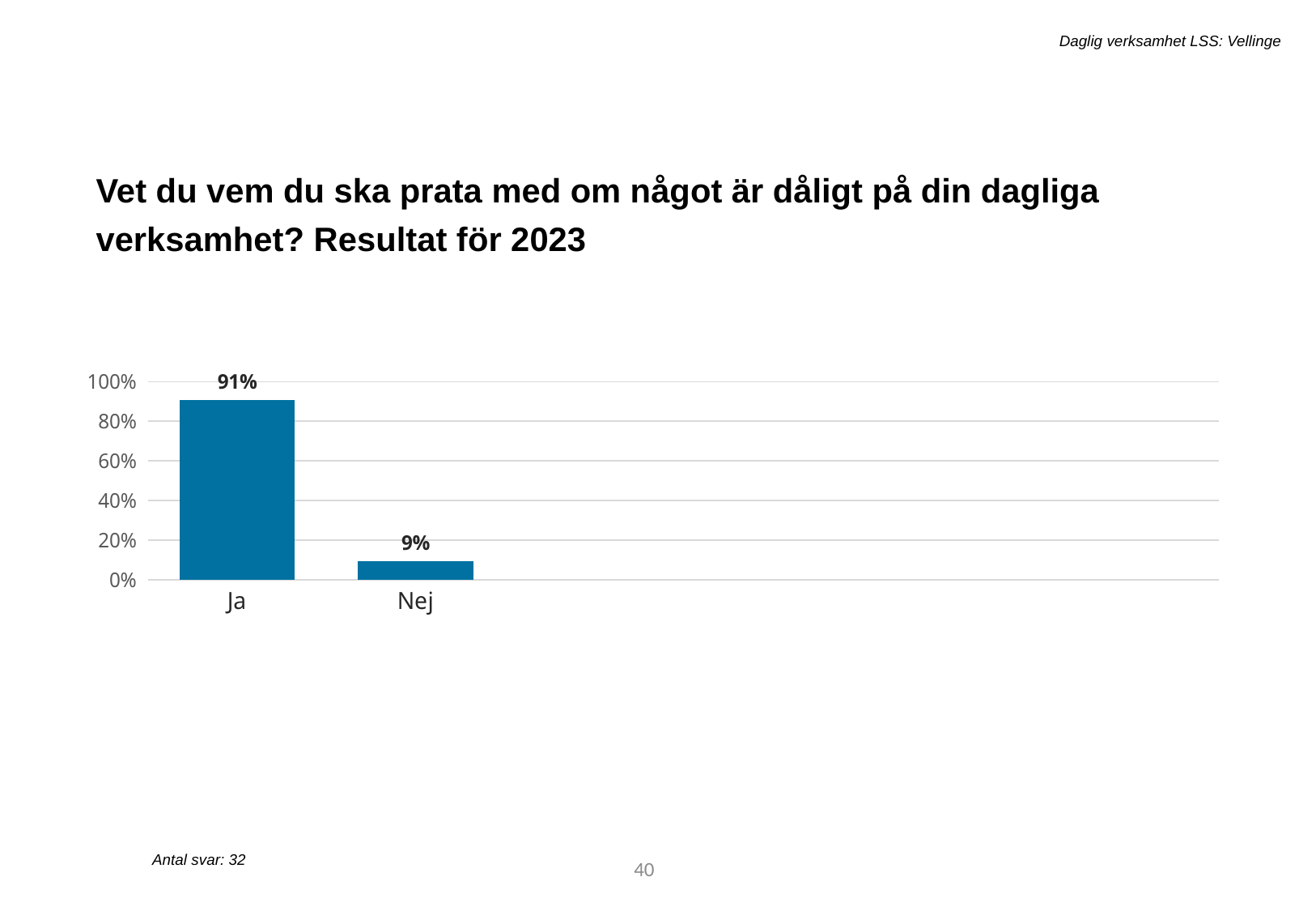
What is the value for Ja? 91% Is the value for Nej greater or less than 20%? less How many categories are shown on the x axis? 2 What is the total of the values for Ja and Nej? 100% What is the difference between the values for Ja and Nej? 82% Which category has the highest value? Ja What kind of chart is shown on the slide? bar chart How many responses (Antal svar) does the slide report? 32 Is the value for Ja greater or less than 80%? greater Which category has the lowest value? Nej Which is larger, the value for Ja or the value for Nej? Ja What is the value for Nej? 9%